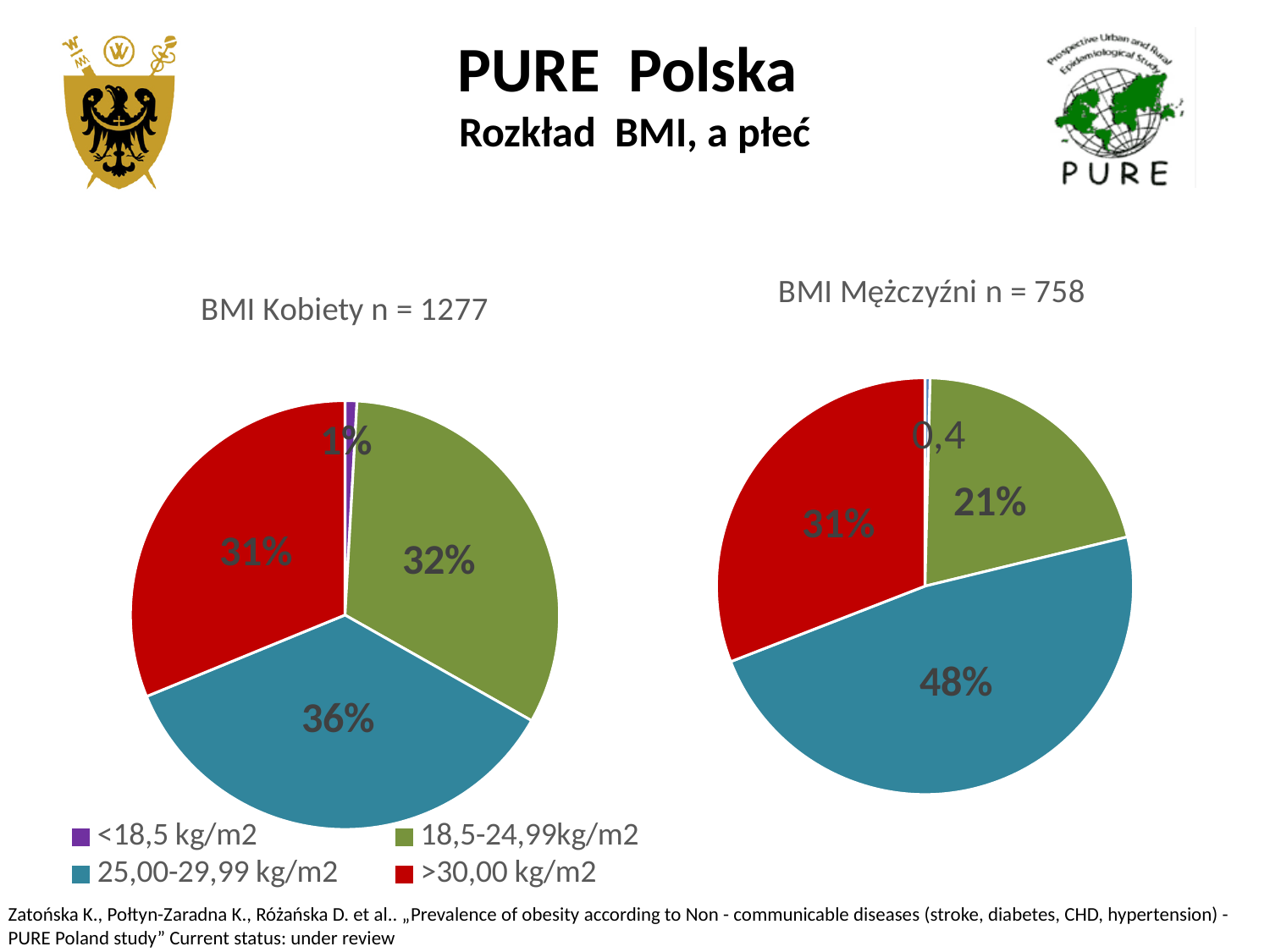
How many entries does the legend list? 4 What colour represents the >30,00 kg/m2 category in the legend? Red In the 'BMI Mężczyźni n = 758' chart, which BMI category has the smallest slice? <18,5 kg/m2 What type of chart is used for 'BMI Kobiety n = 1277'? Pie chart In the 'BMI Kobiety n = 1277' chart, which BMI category has the largest slice? 25,00-29,99 kg/m2 In the 'BMI Kobiety n = 1277' chart, what share is labelled for the 25,00-29,99 kg/m2 slice? 36% How many slices does the 'BMI Mężczyźni n = 758' chart have? 4 Which chart shows a larger share for the 18,5-24,99kg/m2 category, 'BMI Kobiety n = 1277' or 'BMI Mężczyźni n = 758'? BMI Kobiety n = 1277 In the 'BMI Mężczyźni n = 758' chart, what is the difference between the 25,00-29,99 kg/m2 share and the >30,00 kg/m2 share? 17% In the 'BMI Kobiety n = 1277' chart, what share is labelled for the 18,5-24,99kg/m2 slice? 32% In the 'BMI Mężczyźni n = 758' chart, what share is labelled for the 25,00-29,99 kg/m2 slice? 48% In the 'BMI Mężczyźni n = 758' chart, what value is labelled for the <18,5 kg/m2 slice? 0,4